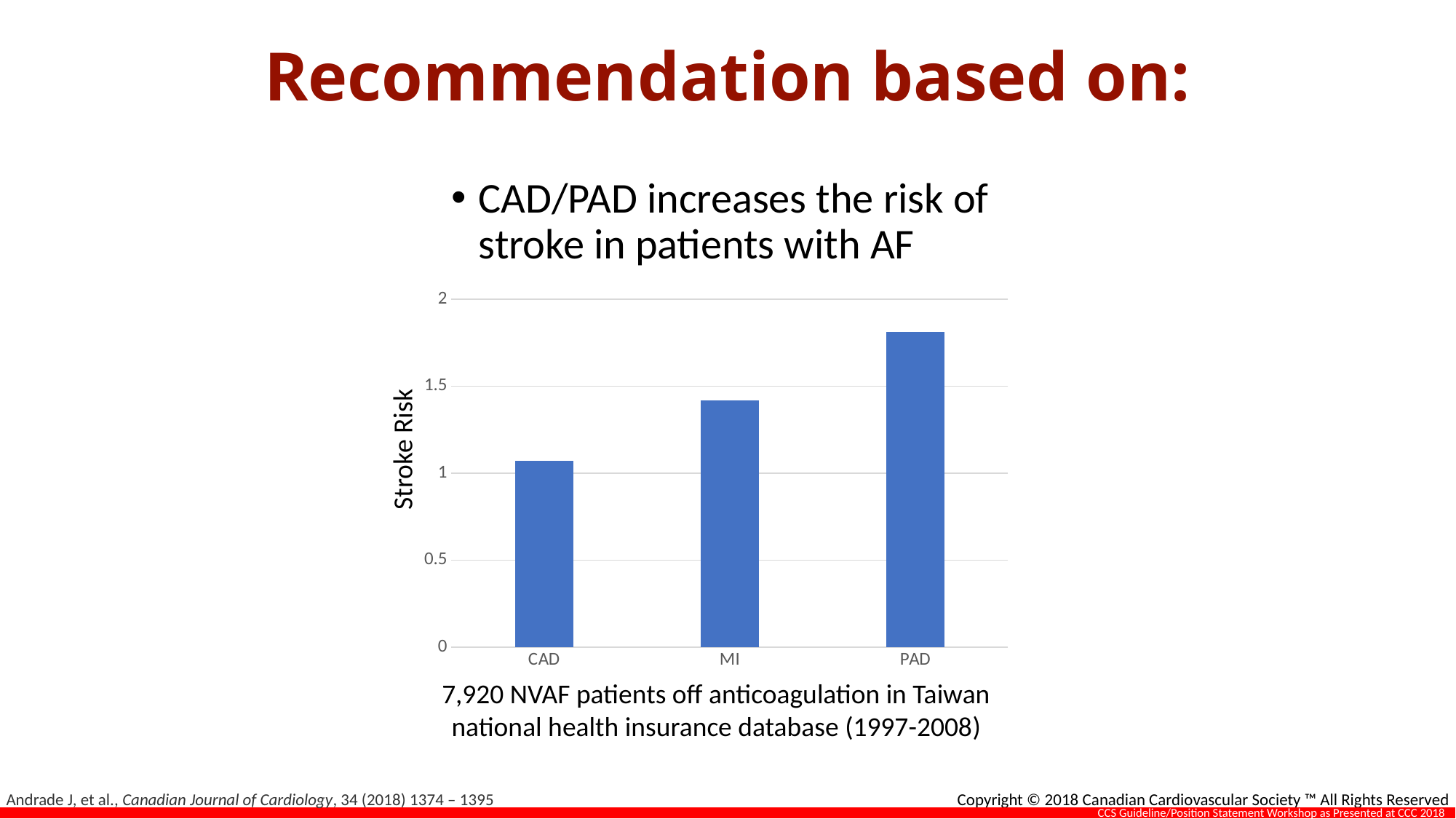
What is the highest tick value shown on the vertical axis? 2 Do the bar values rise or fall from CAD to PAD along the x axis? rise Is the stroke risk for CAD greater or less than 1.5? less What is the label on the vertical axis of the chart? Stroke Risk Is the stroke risk for MI greater or less than 1? greater Which has a higher stroke risk, MI or CAD? MI How many categories are shown on the x axis of the chart? 3 Is the stroke risk for PAD greater or less than 2? less Which category has the lowest stroke risk in the chart? CAD What kind of chart is shown on the slide? bar chart Which category has the highest stroke risk in the chart? PAD